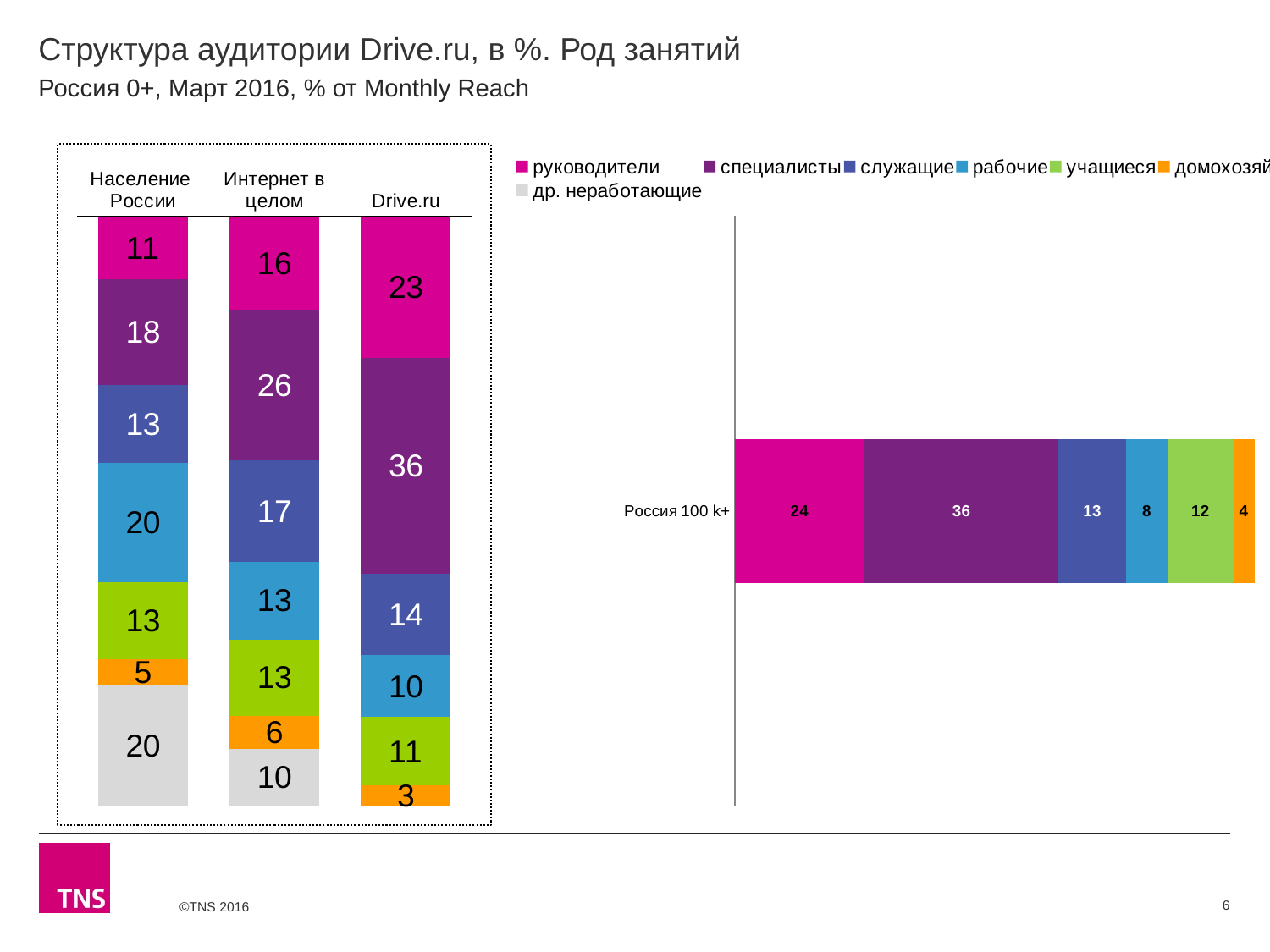
What kind of chart is the right chart (Россия 100 k+)? Stacked bar chart How many categories (bars) are shown in the left chart? 3 In the right chart (Россия 100 k+), what is the value of the учащиеся segment? 12 How many series does the legend list? 7 In the left chart, which has the larger служащие value: Интернет в целом or Drive.ru? Интернет в целом In the left chart, what is the difference between the специалисты values for Drive.ru and Население России? 18 In the right chart, what is the total of all segments in the Россия 100 k+ bar? 97 In the left chart, what is the value of the руководители segment for Интернет в целом? 16 In the left chart, what is the value of the рабочие segment for Население России? 20 In the left chart, which category has the highest руководители value? Drive.ru In the left chart, what is the value of the специалисты segment for Drive.ru? 36 In the right chart (Россия 100 k+), what is the value of the руководители segment? 24